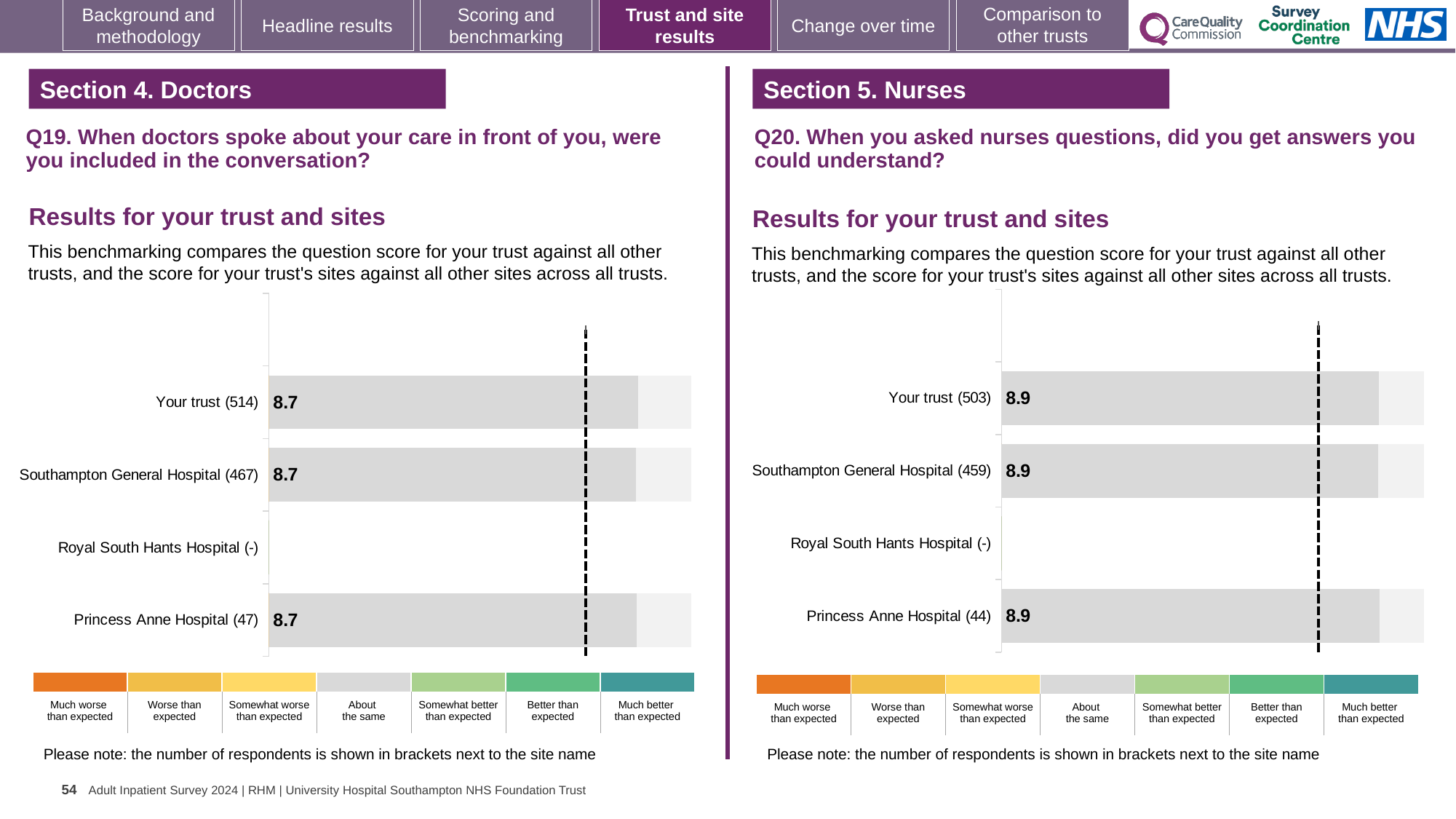
On the Q20 chart (right), how many respondents are shown in brackets for Princess Anne Hospital? 44 On the Q19 chart (left), what is the score for Southampton General Hospital? 8.7 On the Q19 chart (left), what is the score for Your trust? 8.7 On the Q19 chart (left), how many sites or trust rows are listed on the vertical axis? 4 On the Q20 chart (right), which row has no score shown? Royal South Hants Hospital (-) On the Q20 chart (right), what is the score for Princess Anne Hospital? 8.9 On the Q20 chart (right), what is the score for Your trust? 8.9 What kind of chart is used on the Q19 chart (left)? Bar chart On the Q19 chart (left), how many respondents are shown in brackets for Your trust? 514 What is the difference between the Your trust score on the Q20 chart (right) and the Your trust score on the Q19 chart (left)? 0.2 On the Q20 chart (right), what is the score for Southampton General Hospital? 8.9 On the Q19 chart (left), what is the score for Princess Anne Hospital? 8.7